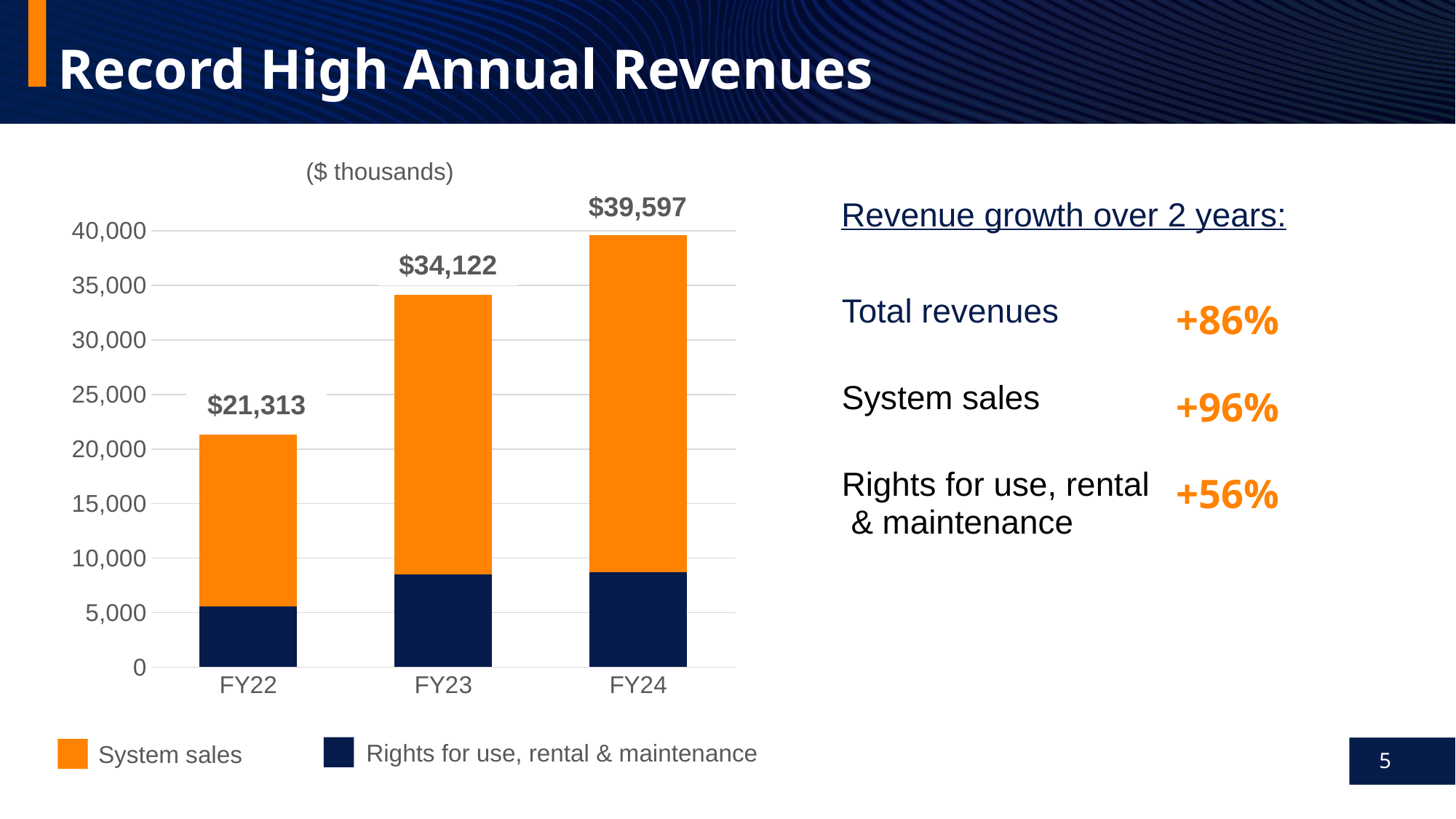
What is the total revenue shown for FY22? $21,313 What is the difference between the FY23 and FY22 total revenues? $12,809 How many fiscal years are shown on the x axis? 3 Is the Rights for use, rental & maintenance value for FY22 greater or less than 10,000? less What is the total revenue shown for FY24? $39,597 Which fiscal year has the lowest total revenue? FY22 What is the difference between the FY24 and FY23 total revenues? $5,475 What is the total revenue shown for FY23? $34,122 How many series does the legend list? 2 What kind of chart is shown on the slide? Stacked bar chart Which fiscal year has the highest total revenue? FY24 Do total revenues rise or fall from FY22 to FY24? Rise